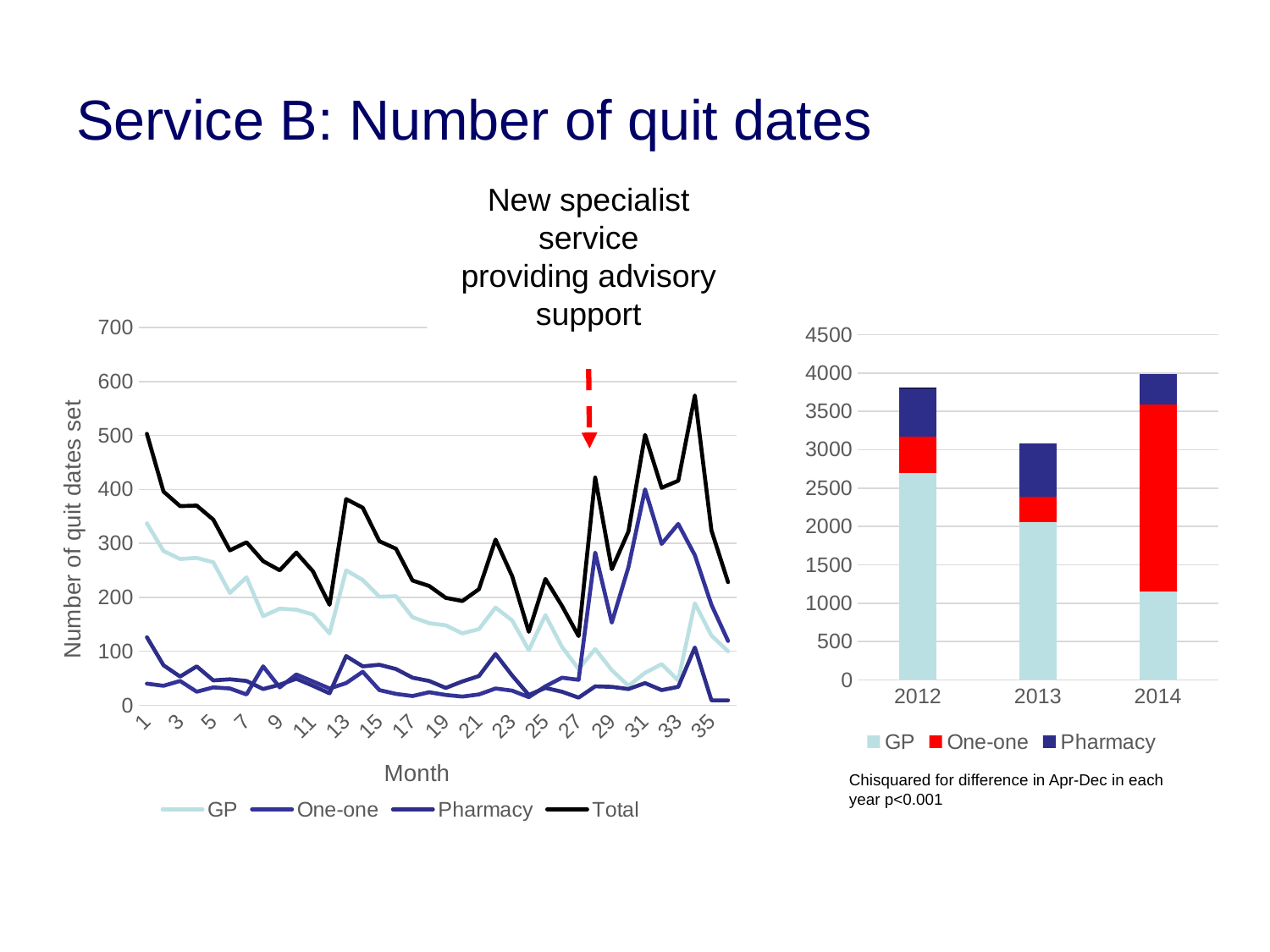
What kind of chart is the chart on the right of the slide? bar chart In the right-hand stacked bar chart, is the GP value for 2012 greater or less than 2500? greater What kind of chart is the chart on the left of the slide? line chart In the right-hand stacked bar chart, is the GP value for 2014 greater or less than 1500? less In the left-hand line chart, is the Total value at month 1 greater or less than 400? greater How many years are shown on the x axis of the right-hand stacked bar chart? 3 In the right-hand stacked bar chart, which year has the shortest total bar? 2013 In the right-hand stacked bar chart, which year has the tallest total bar? 2014 How many series does the legend of the left-hand line chart list? 4 How many series does the legend of the right-hand stacked bar chart list? 3 In the right-hand stacked bar chart, is the One-one segment larger in 2014 or in 2012? 2014 In the left-hand line chart, does the GP series generally rise or fall from month 1 to month 27? fall